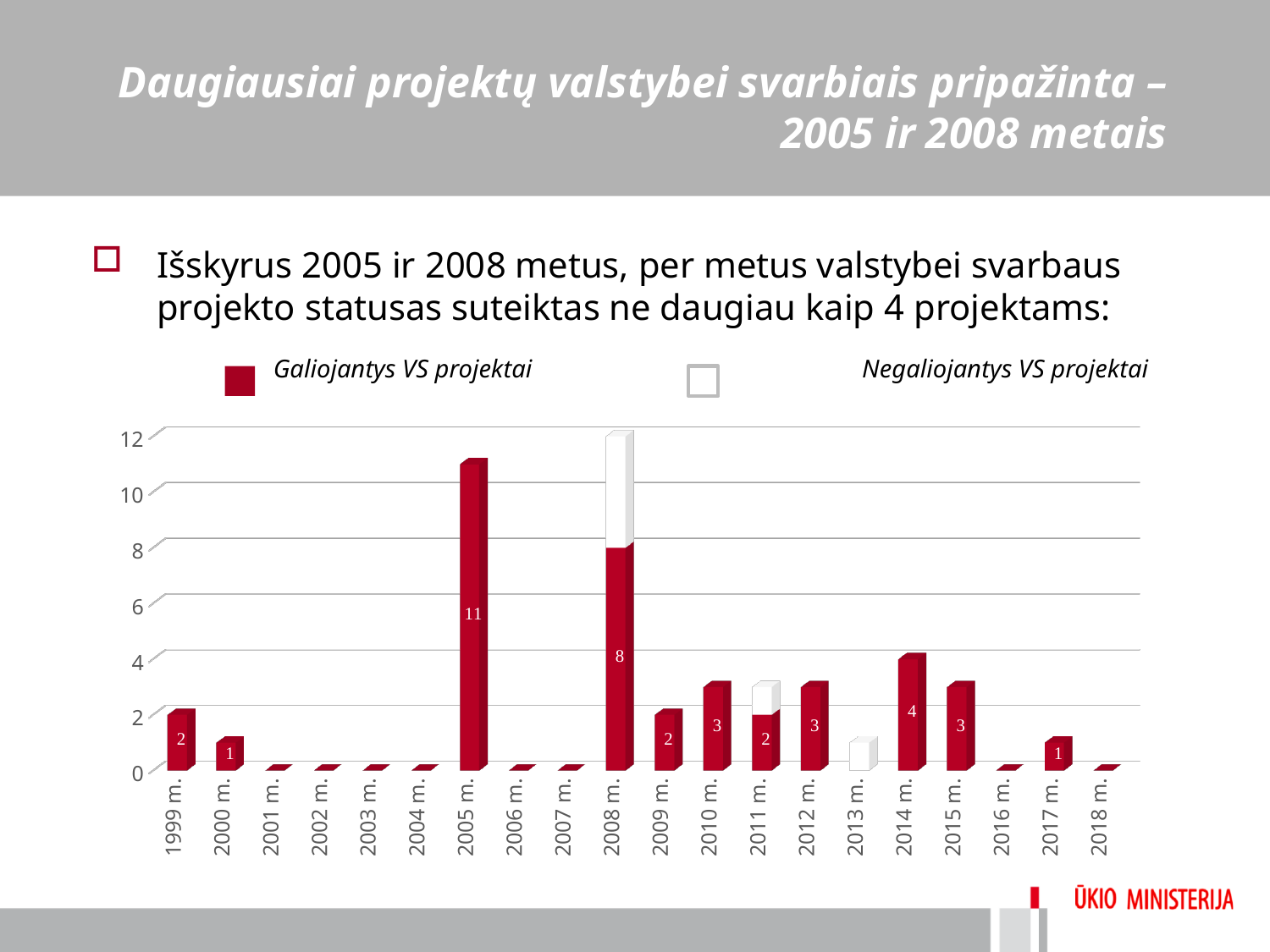
How many years are shown on the x axis of the chart? 20 Which year has the larger Galiojantys VS projektai value, 2014 m. or 2015 m.? 2014 m. What is the value of Galiojantys VS projektai for 2014 m.? 4 What is the value of Galiojantys VS projektai for 2008 m.? 8 What is the value of Galiojantys VS projektai for 2017 m.? 1 What is the difference between the Galiojantys VS projektai values for 2005 m. and 2008 m.? 3 Which series is shown in red in the chart legend? Galiojantys VS projektai What is the value of Galiojantys VS projektai for 2005 m.? 11 What kind of chart is shown on the slide? bar chart How many series does the chart legend list? 2 Is the total height of the stacked bar for 2008 m. greater or less than 10? greater Which year has the highest value for Galiojantys VS projektai? 2005 m.